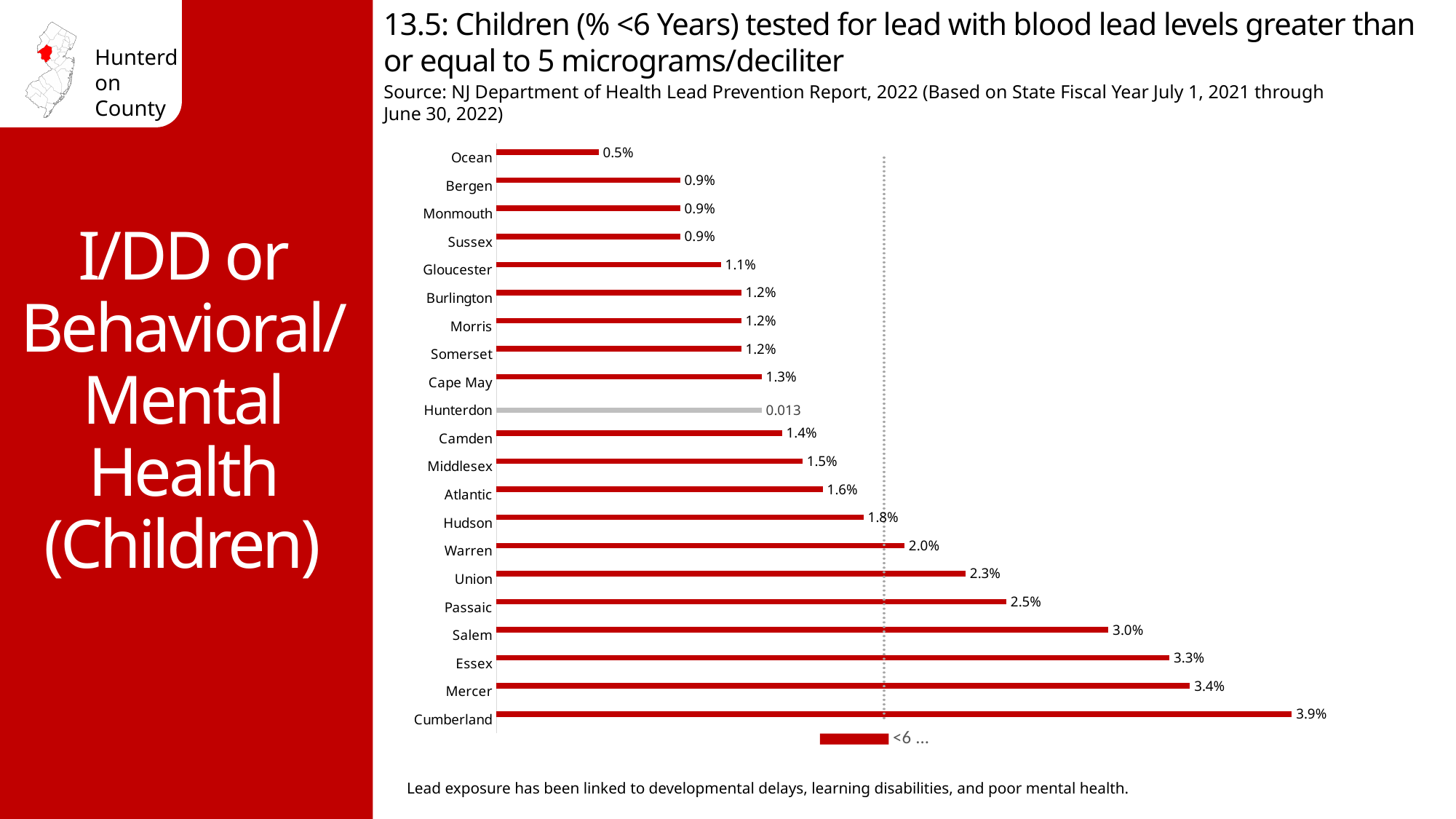
What kind of chart is shown on the slide? Bar chart What is the value for Cumberland? 3.9% Which county has the lowest value? Ocean What is the value for Warren? 2.0% Which has a larger value, Essex or Passaic? Essex What is the difference between the values for Salem and Ocean? 2.5% Do the values increase or decrease going from the top bar (Ocean) to the bottom bar (Cumberland)? Increase What label is printed next to the Hunterdon bar? 0.013 Which county has the highest value? Cumberland What is the difference between the values for Cumberland and Mercer? 0.5% How many counties are shown in the chart? 21 What colour is the Hunterdon bar, unlike the other bars? Gray